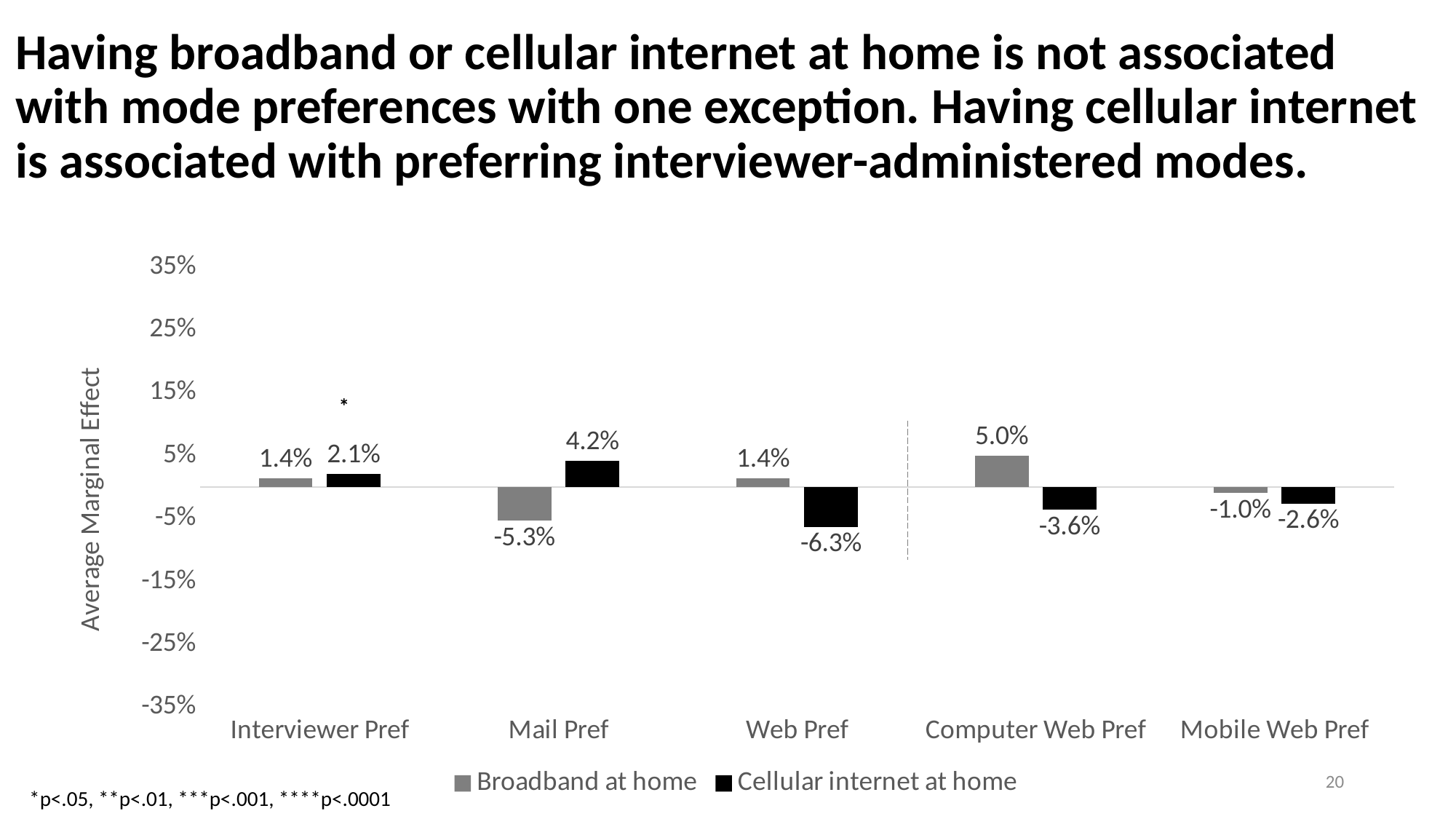
What is the average marginal effect of Cellular internet at home for Web Pref? -6.3% What is the value for Cellular internet at home for Mail Pref? 4.2% What kind of chart is shown on the slide? Bar chart Which category has the lowest value for Cellular internet at home? Web Pref What is the value for Broadband at home for Mobile Web Pref? -1.0% How many series does the legend list? 2 What is the label of the vertical axis? Average Marginal Effect For Mail Pref, which series has the larger value: Broadband at home or Cellular internet at home? Cellular internet at home How many preference categories are shown on the x axis? 5 What is the average marginal effect of Broadband at home for Computer Web Pref? 5.0% What is the difference between the Broadband at home and Cellular internet at home values for Interviewer Pref? 0.7% Which category has the highest value for Broadband at home? Computer Web Pref